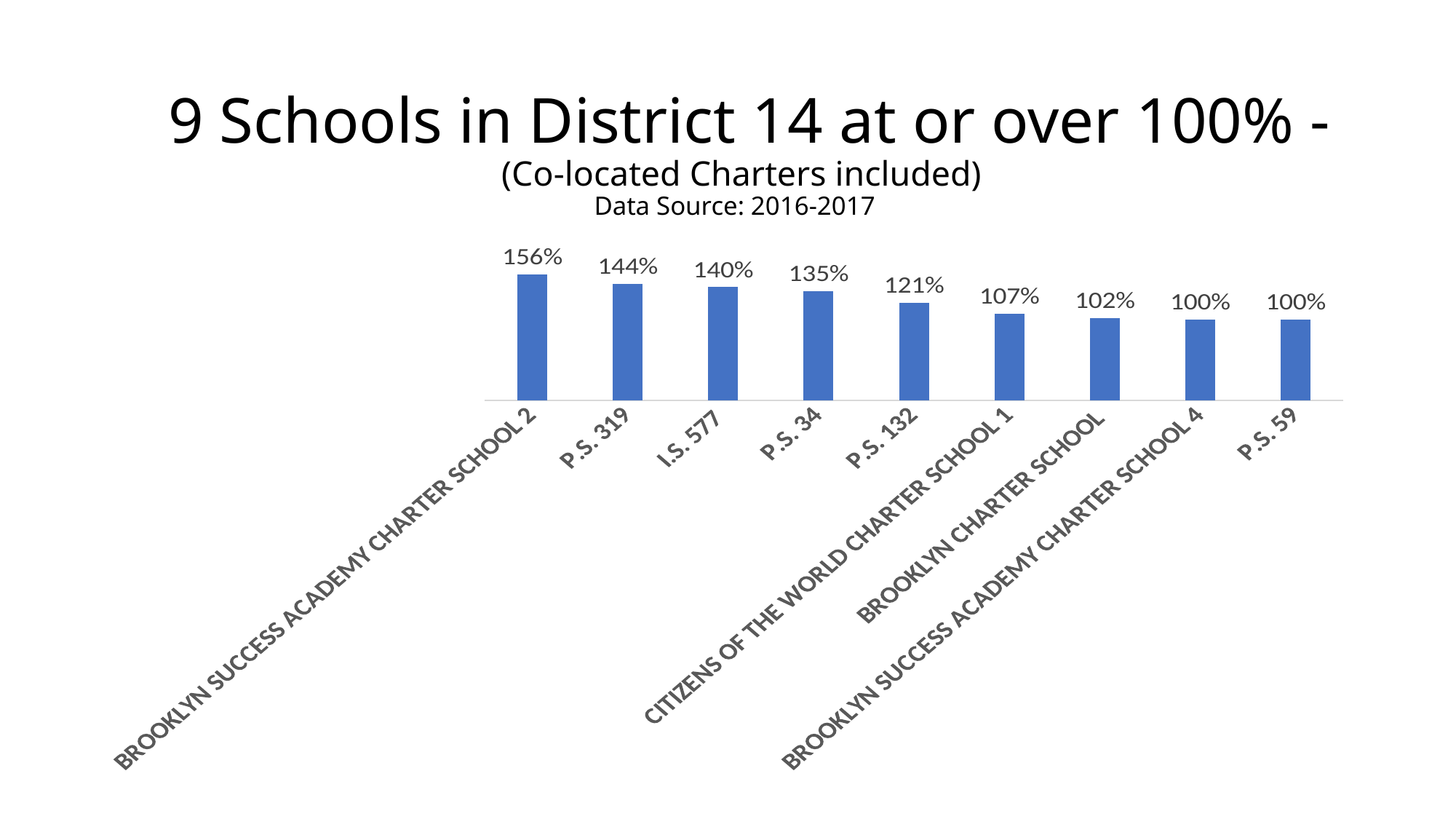
What is the value for Brooklyn Charter School? 102% What is the value for Citizens of the World Charter School 1? 107% Do the values rise or fall from left to right across the chart? Fall What is the value for I.S. 577? 140% Which is larger, the value for P.S. 319 or the value for P.S. 34? P.S. 319 What is the value for P.S. 319? 144% What data source year is given below the chart title? 2016-2017 How many schools are shown in the chart? 9 Which school has the highest value? Brooklyn Success Academy Charter School 2 What is the difference between the values for P.S. 34 and P.S. 132? 14% What is the difference between the values for Brooklyn Success Academy Charter School 2 and P.S. 59? 56% What kind of chart is shown on the slide? Bar chart